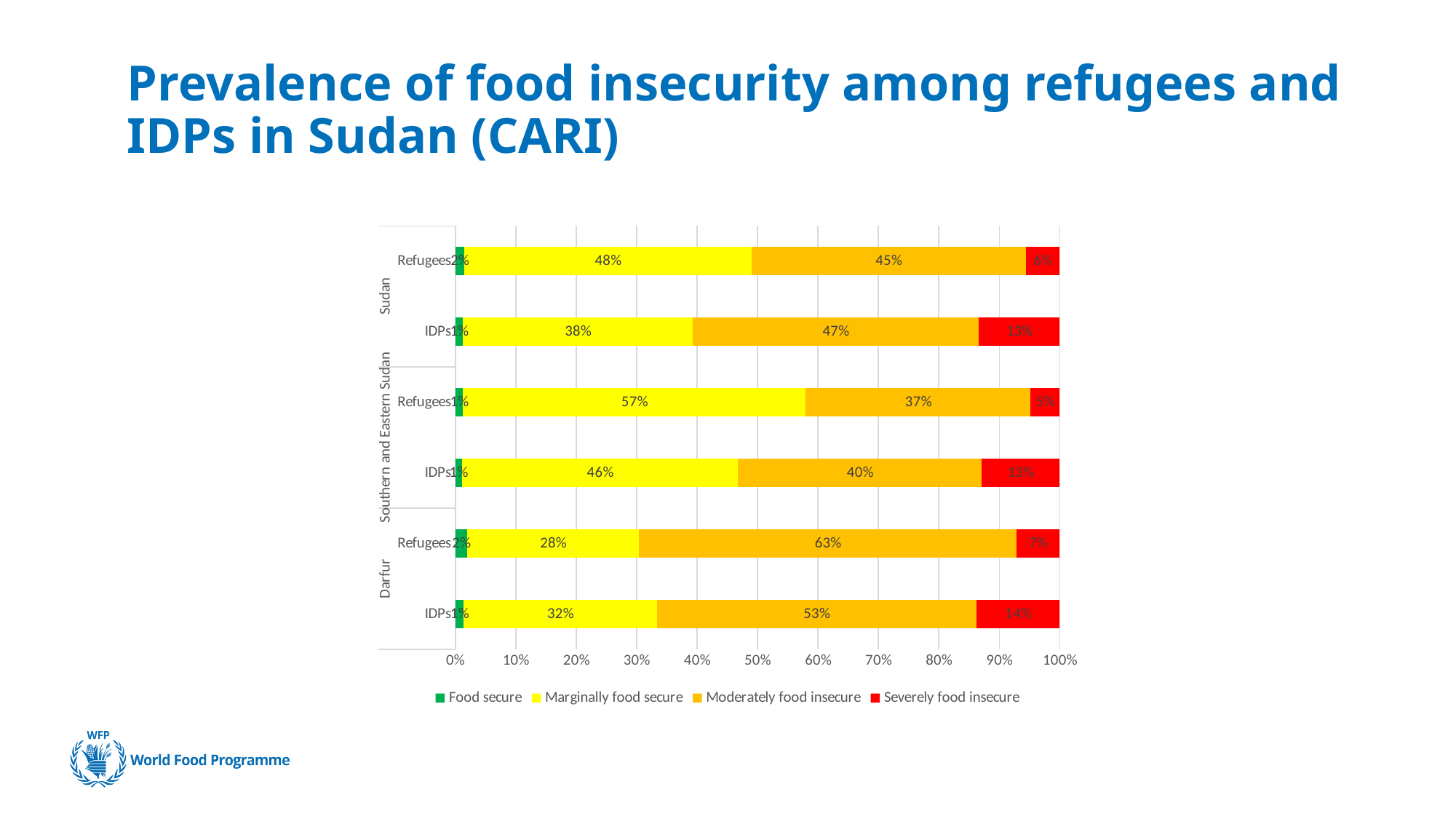
Which is larger: the Severely food insecure value for IDPs in Sudan or for Refugees in Sudan? IDPs in Sudan How many bars are plotted in the chart? 6 What is the Severely food insecure value for IDPs in Darfur? 14% Which bar has the lowest Marginally food secure value? Refugees in Darfur Which bar has the highest Severely food insecure value? IDPs in Darfur What is the Marginally food secure value for Refugees in Southern and Eastern Sudan? 57% What is the Moderately food insecure value for Refugees in Darfur? 63% Which legend entry is shown in red? Severely food insecure What is the difference between the Moderately food insecure values for Refugees in Darfur and Refugees in Southern and Eastern Sudan? 26% How many series does the legend list? 4 What is the Moderately food insecure value for IDPs in Sudan? 47% What kind of chart is shown on the slide? Stacked bar chart